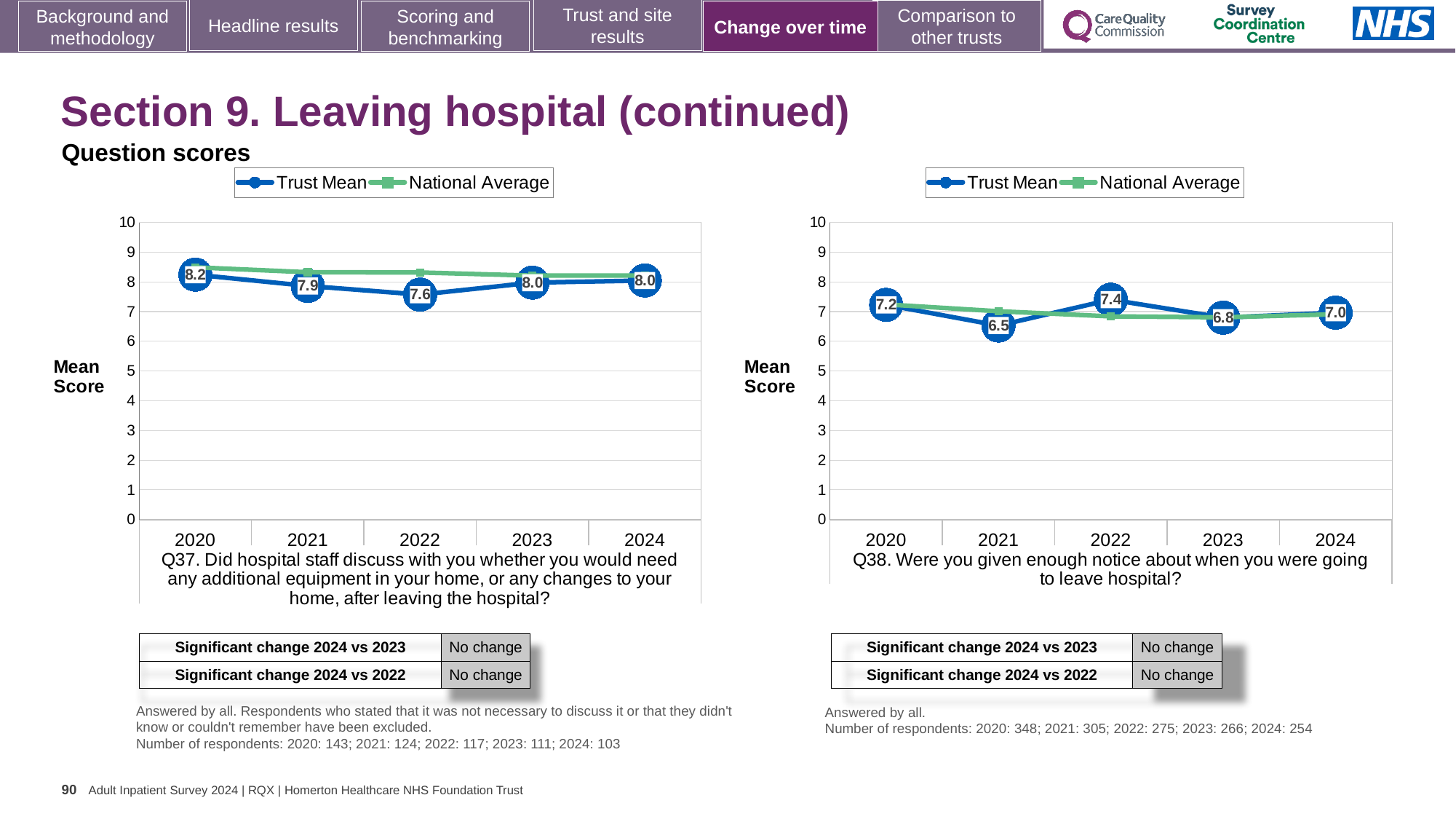
What kind of chart is the Q37 chart (left)? Line chart On the Q37 chart (left), what is the Trust Mean score for 2022? 7.6 On the Q37 chart (left), which year has the highest Trust Mean score? 2020 On the Q38 chart (right), is the National Average for 2021 greater or less than 8? less On the Q38 chart (right), which year has the lowest Trust Mean score? 2021 On the Q37 chart (left), is the Trust Mean score for 2020 or 2022 larger? 2020 On the Q38 chart (right), what is the Trust Mean score for 2021? 6.5 On the Q37 chart (left), does the Trust Mean rise or fall from 2020 to 2022? Fall How many series does the legend of the Q38 chart (right) list? 2 How many years are plotted on the Q37 chart (left)? 5 What is the y-axis label on the Q38 chart (right)? Mean Score On the Q38 chart (right), what is the difference between the Trust Mean scores for 2022 and 2021? 0.9